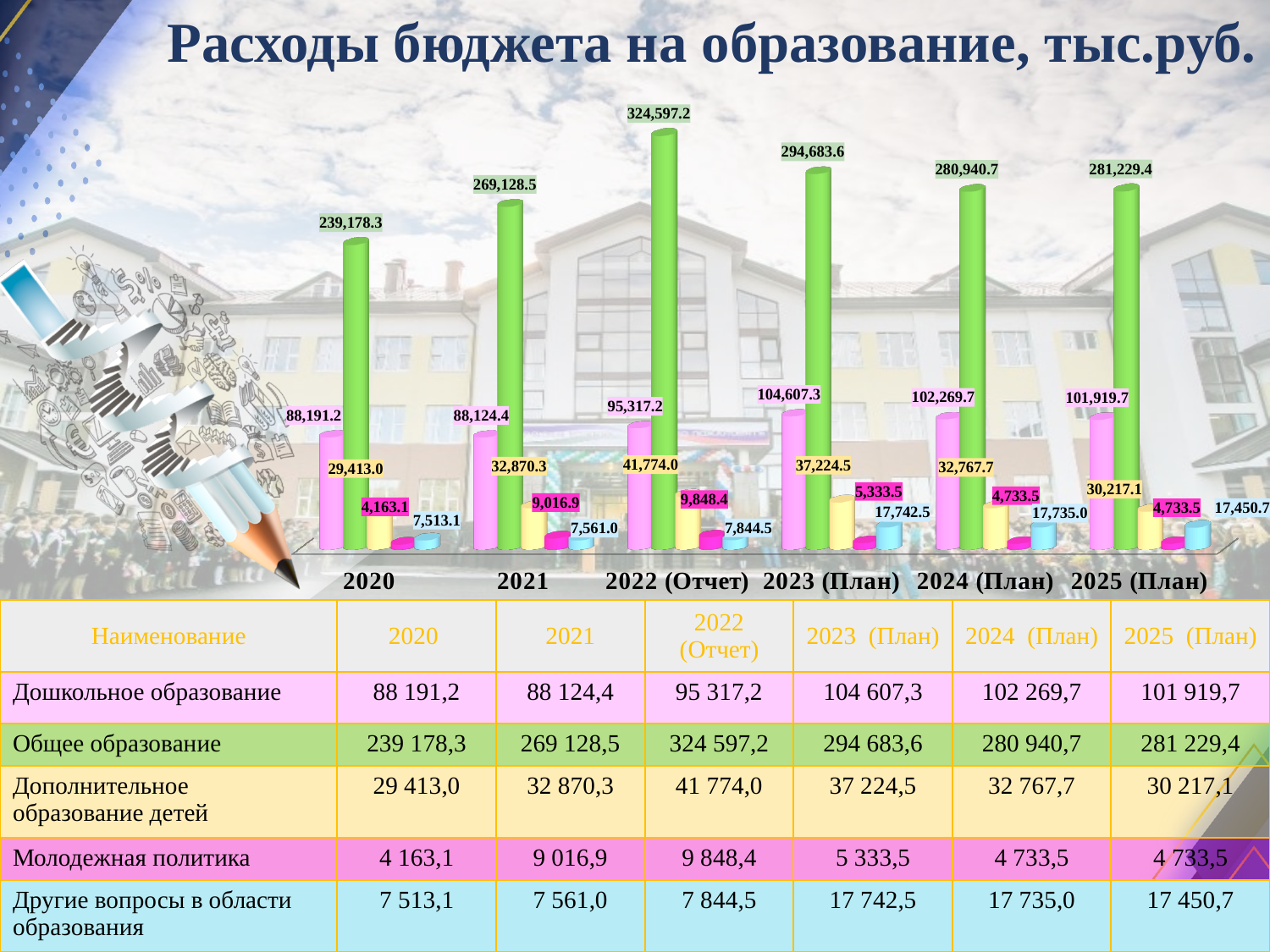
What is the value of the tallest (green) bar for 2022 (Отчет)? 324,597.2 What is the difference between the green bar values for 2022 (Отчет) and 2023 (План)? 29,913.6 In which year does the green bar (Общее образование) reach its highest value? 2022 (Отчет) What is the title of the chart? Расходы бюджета на образование, тыс.руб. What is the value of the pink bar (Дошкольное образование) for 2023 (План)? 104,607.3 What is the difference between the light blue bar values for 2023 (План) and 2022 (Отчет)? 9,898.0 Does the green bar (Общее образование) rise or fall from 2020 to 2022 (Отчет)? Rise How many year categories are shown along the x axis of the chart? 6 In which year is the magenta bar (Молодежная политика) lowest? 2020 What kind of chart is shown on the slide? Bar chart Which is larger for 2021: the yellow bar (32,870.3) or the magenta bar (9,016.9)? The yellow bar (32,870.3) What is the value of the light blue bar (Другие вопросы в области образования) for 2025 (План)? 17,450.7